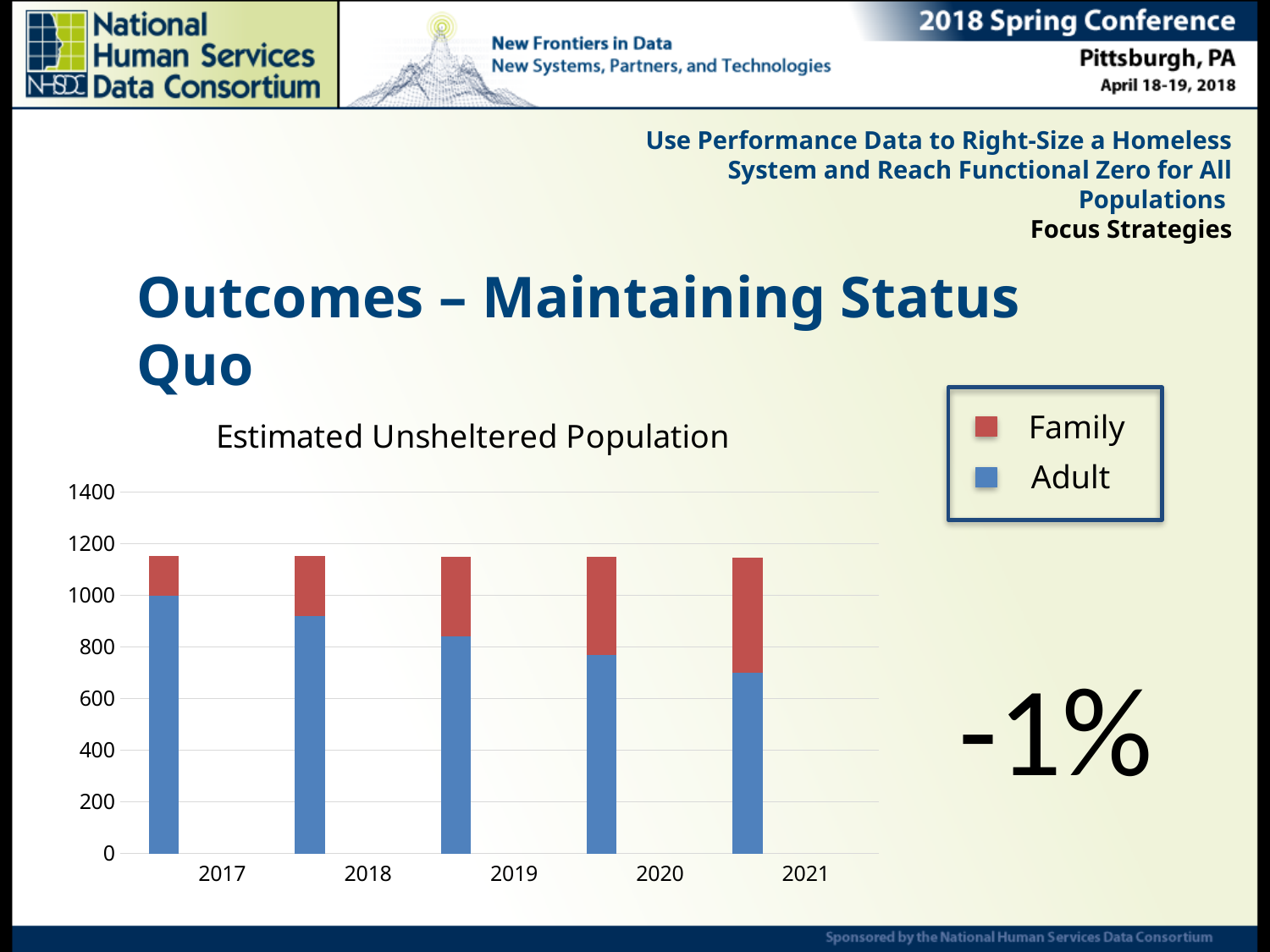
In which year is the Adult value highest? 2017 How many series does the legend list? 2 Is the Adult value for 2021 greater or less than 800? less Which colour represents the Family series in the chart? Red Is the Family value for 2021 greater or less than 200? greater What is the title of the chart? Estimated Unsheltered Population Which is larger, the Adult value for 2017 or the Adult value for 2021? 2017 Is the total bar height for 2017 greater or less than 1000? greater How many years are shown on the x axis of the chart? 5 What kind of chart is shown on the slide? Stacked bar chart In which year is the Adult value lowest? 2021 Does the Adult portion of the bars rise or fall from 2017 to 2021? Fall